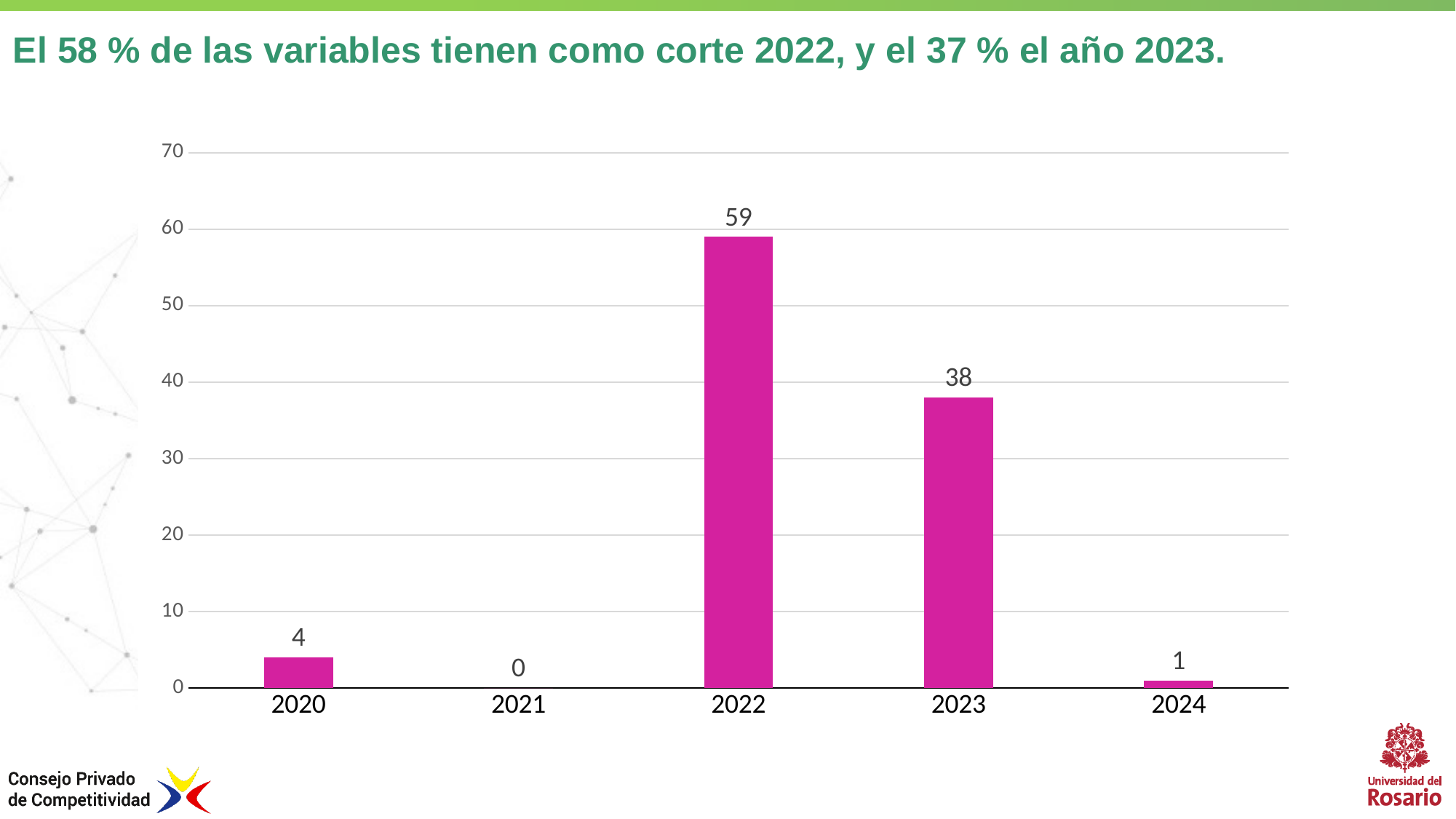
Is the value for 2023 greater or less than 40? less What is the value for 2020? 4 What is the value for 2024? 1 What is the value for 2023? 38 How many years are shown on the x axis? 5 Which is larger, the value for 2020 or the value for 2024? 2020 Which year has the lowest value? 2021 Which year has the highest value? 2022 What is the difference between the values for 2022 and 2023? 21 What kind of chart is shown on the slide? bar chart What is the value for 2022? 59 What is the total of all the values shown in the chart? 102